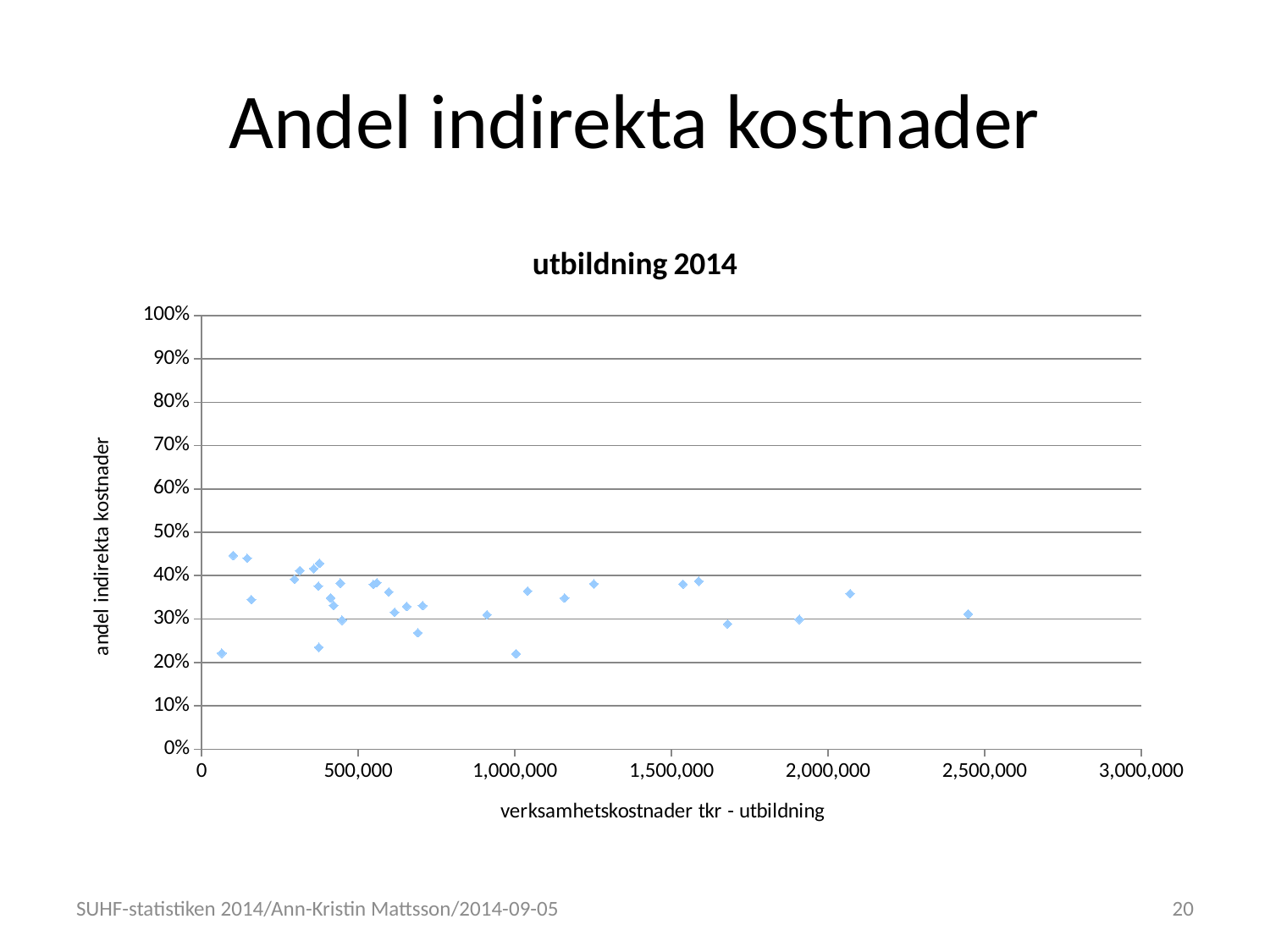
Do the values show a strong rising trend as the x value increases? No What kind of chart is shown on the slide? scatter chart Is the value for the point with the highest x value (around 2,500,000) greater or less than 40%? less What is the title of the chart? utbildning 2014 Are any of the plotted points above 50% on the y axis? No Are any of the plotted points below 20% on the y axis? No What is the label of the x axis? verksamhetskostnader tkr - utbildning